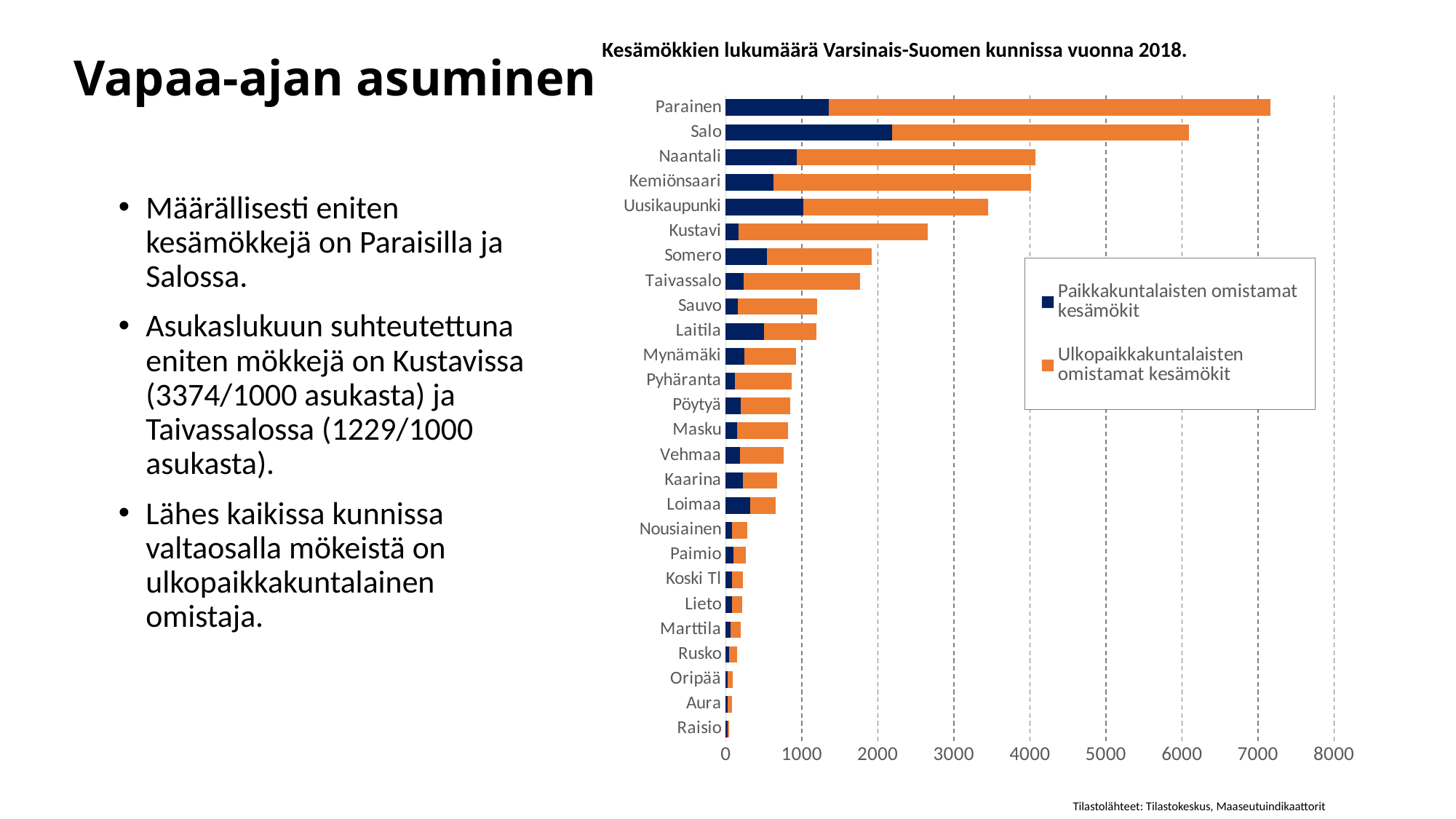
Which municipality has the highest total number of summer cottages in the chart? Parainen Which has a larger total number of summer cottages, Kustavi or Somero? Kustavi Which colour represents the series 'Ulkopaikkakuntalaisten omistamat kesämökit' in the chart? orange Is the total value for Uusikaupunki greater or less than 4000? less Which municipality has the lowest total number of summer cottages in the chart? Raisio Is the total value for Taivassalo greater or less than 2000? less How many series does the chart's legend list? 2 How many municipalities are shown in the chart? 26 Is the total value for Kustavi greater or less than 2000? greater What is the title of the chart? Kesämökkien lukumäärä Varsinais-Suomen kunnissa vuonna 2018. What kind of chart is shown on the slide? bar chart